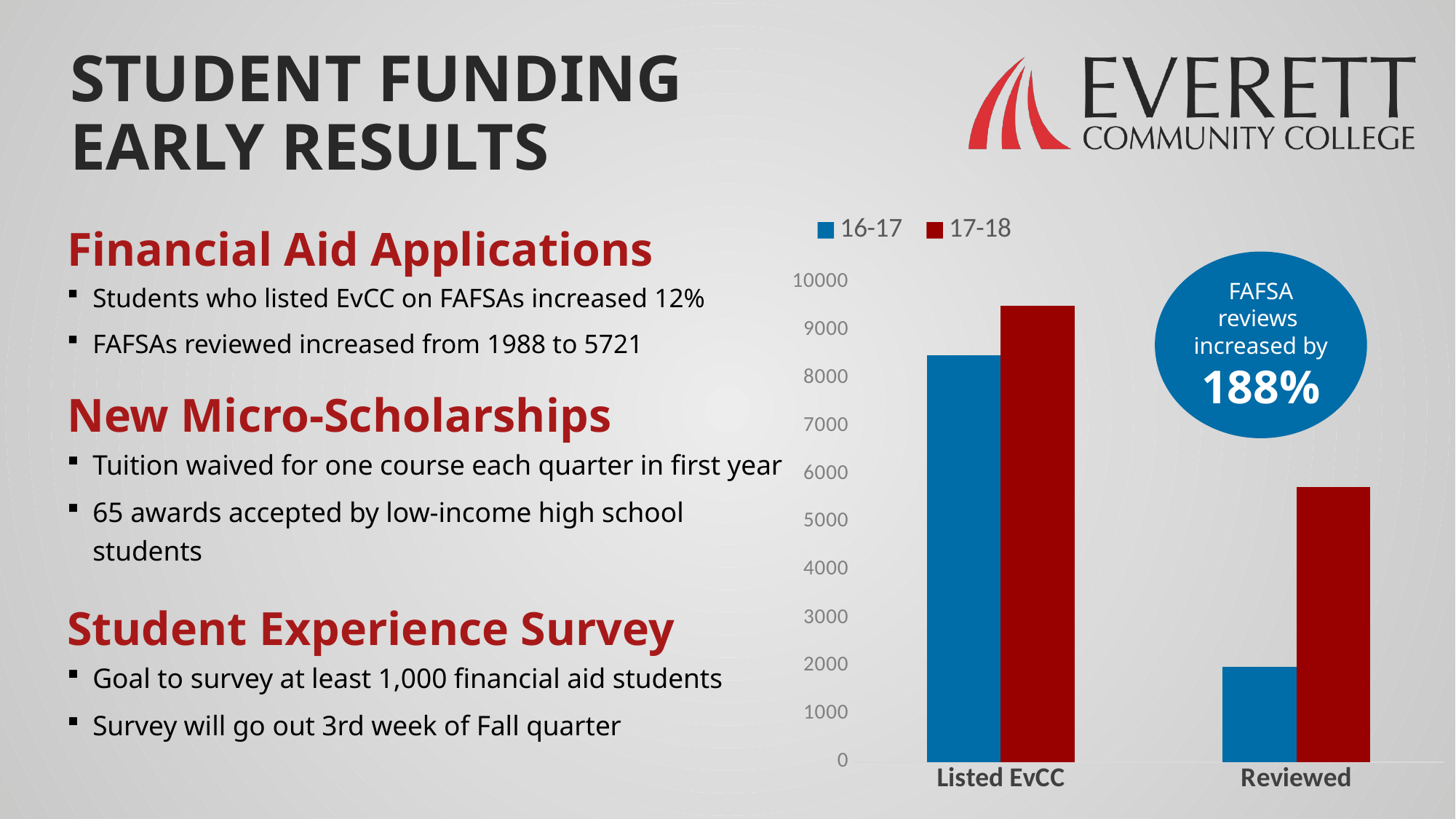
Which bar in the chart is the lowest overall? Reviewed, 16-17 Is the 17-18 value for Listed EvCC greater or less than 9000? greater What are the two series named in the chart's legend? 16-17 and 17-18 How many categories are shown on the x axis of the chart? 2 How many series does the chart's legend list? 2 Which colour represents the 17-18 series in the chart? red Is the 17-18 value for Reviewed greater or less than 5000? greater Which category has the taller 17-18 bar, Listed EvCC or Reviewed? Listed EvCC What kind of chart is shown on the right side of the slide? bar chart For Listed EvCC, which series has the larger value, 16-17 or 17-18? 17-18 Is the 16-17 value for Listed EvCC greater or less than 8000? greater